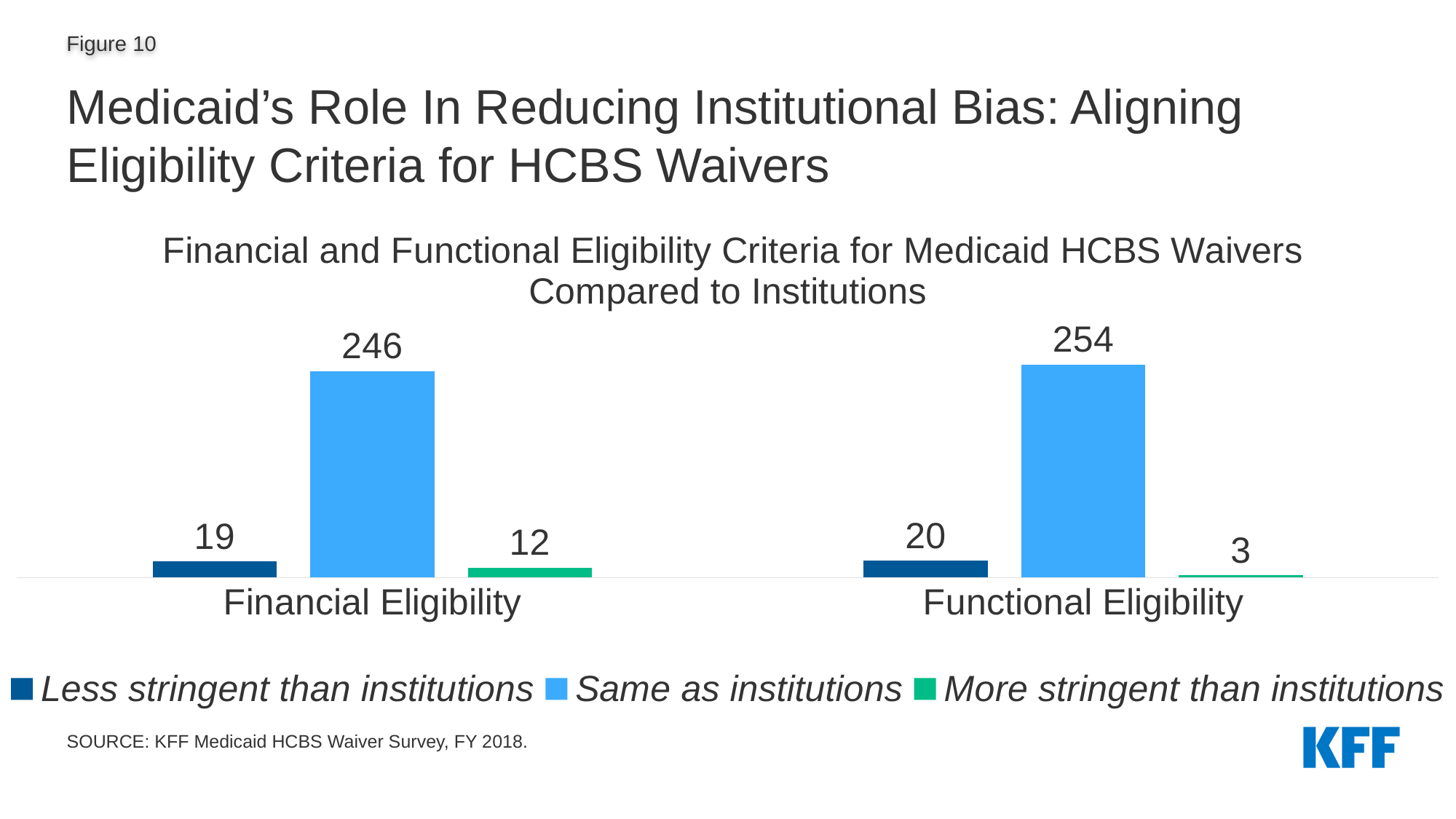
What is the difference between the 'Same as institutions' values for Functional Eligibility and Financial Eligibility? 8 Which series has the highest value under Functional Eligibility? Same as institutions What is the title of the chart? Financial and Functional Eligibility Criteria for Medicaid HCBS Waivers Compared to Institutions What is the value for 'More stringent than institutions' under Functional Eligibility? 3 Which series has the lowest value under Financial Eligibility? More stringent than institutions How many series does the legend list? 3 Which is larger: 'Less stringent than institutions' for Financial Eligibility or for Functional Eligibility? Functional Eligibility What is the difference between 'Less stringent than institutions' and 'More stringent than institutions' under Financial Eligibility? 7 What is the value for 'Same as institutions' under Financial Eligibility? 246 What is the value for 'Less stringent than institutions' under Functional Eligibility? 20 How many categories are shown on the x axis? 2 What kind of chart is shown on the slide? Bar chart